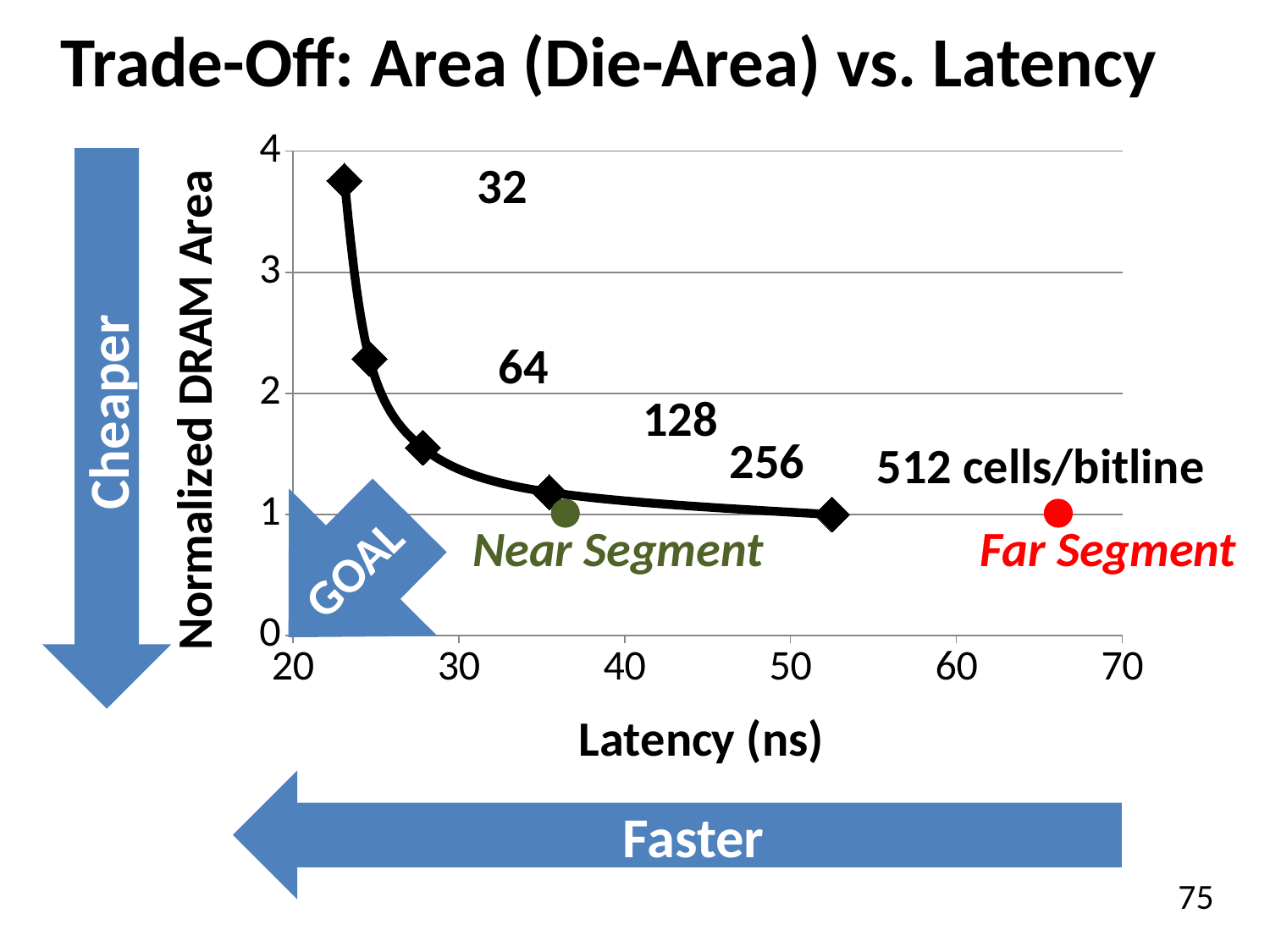
What is the title of the slide's chart? Trade-Off: Area (Die-Area) vs. Latency What kind of chart is shown on the slide? scatter (line) chart Which cells/bitline configuration has the highest normalized DRAM area? 32 As latency increases along the x axis, does the normalized DRAM area rise or fall? fall Is the normalized DRAM area for the 128 cells/bitline point greater or less than 2? less What is the label of the x axis? Latency (ns) Is the normalized DRAM area for the 32 cells/bitline point greater or less than 3? greater Is the latency for the 32 cells/bitline point greater or less than 30 ns? less How many cells/bitline configurations are plotted as black diamond points on the curve? 5 Which cells/bitline configuration has the lowest normalized DRAM area? 512 Which has the higher normalized DRAM area, the 64 cells/bitline point or the 256 cells/bitline point? 64